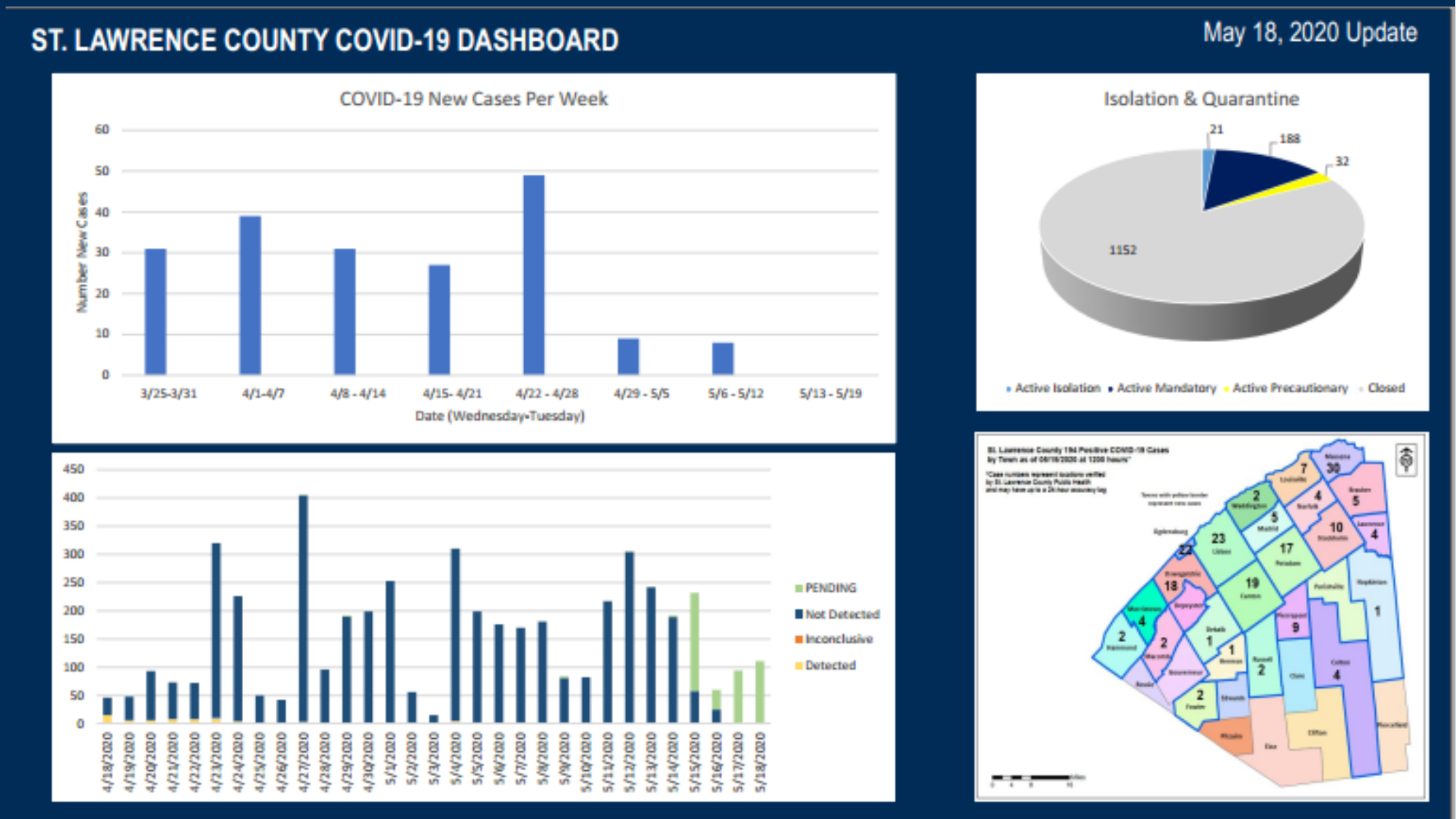
What kind of chart is the 'COVID-19 New Cases Per Week' chart? Bar chart In the 'COVID-19 New Cases Per Week' chart, is the value for 4/22 - 4/28 greater or less than 40? greater In the 'COVID-19 New Cases Per Week' chart, is the value for 4/29 - 5/5 greater or less than 20? less In the 'Isolation & Quarantine' pie chart, what is the value for Closed? 1152 In the 'Isolation & Quarantine' pie chart, what is the value for Active Mandatory? 188 In the 'Isolation & Quarantine' pie chart, what is the difference between Active Mandatory and Active Precautionary? 156 In the 'Isolation & Quarantine' pie chart, which category has the smallest value? Active Isolation How many series does the legend of the bottom-left stacked bar chart list? 4 In the 'COVID-19 New Cases Per Week' chart, which week has the highest number of new cases? 4/22 - 4/28 In the 'COVID-19 New Cases Per Week' chart, how many date categories are shown on the x axis? 8 In the 'COVID-19 New Cases Per Week' chart, which week has more new cases, 4/1-4/7 or 4/8 - 4/14? 4/1-4/7 In the bottom-left stacked bar chart, which date has the tallest bar? 4/27/2020